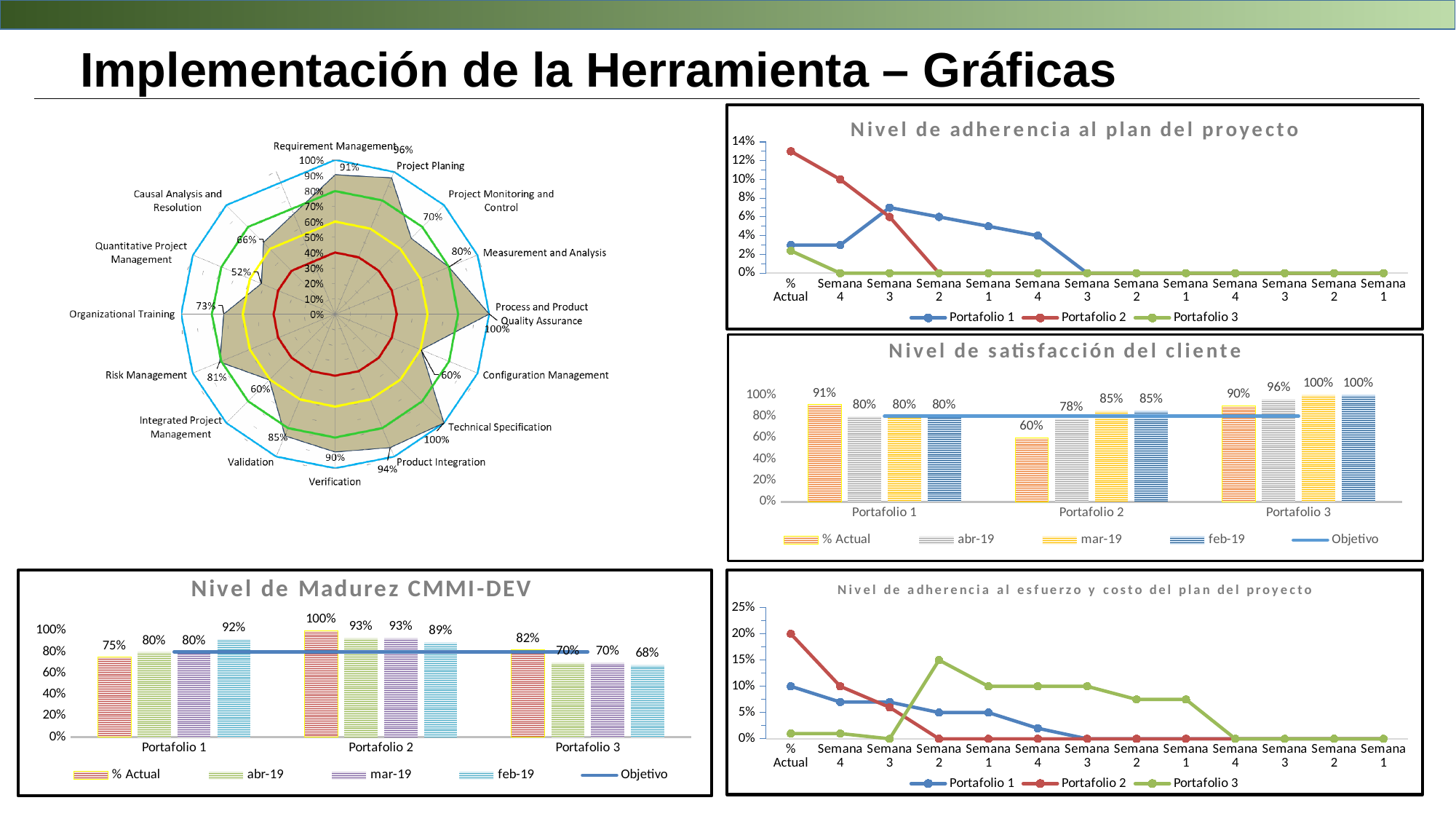
What kind of chart is 'Nivel de adherencia al esfuerzo y costo del plan del proyecto'? line chart In the 'Nivel de satisfacción del cliente' chart, what is the % Actual value for Portafolio 2? 60% In the 'Nivel de satisfacción del cliente' chart, what is the difference between the % Actual value for Portafolio 1 and the % Actual value for Portafolio 2? 31% In the 'Nivel de Madurez CMMI-DEV' chart, what is the feb-19 value for Portafolio 3? 68% In the 'Nivel de Madurez CMMI-DEV' chart, how many series does the legend list? 5 In the 'Nivel de adherencia al esfuerzo y costo del plan del proyecto' chart, how many series does the legend list? 3 In the radar chart on the left, which is larger, the value for Risk Management or the value for Organizational Training? Risk Management In the radar chart on the left, what is the value for Causal Analysis and Resolution? 36% In the radar chart on the left, what is the value for Product Integration? 94% In the 'Nivel de Madurez CMMI-DEV' chart, what is the % Actual value for Portafolio 2? 100% In the 'Nivel de satisfacción del cliente' chart, which portfolio has the highest mar-19 value? Portafolio 3 In the 'Nivel de adherencia al plan del proyecto' chart, is the value for Portafolio 2 at '% Actual' greater or less than 10%? greater